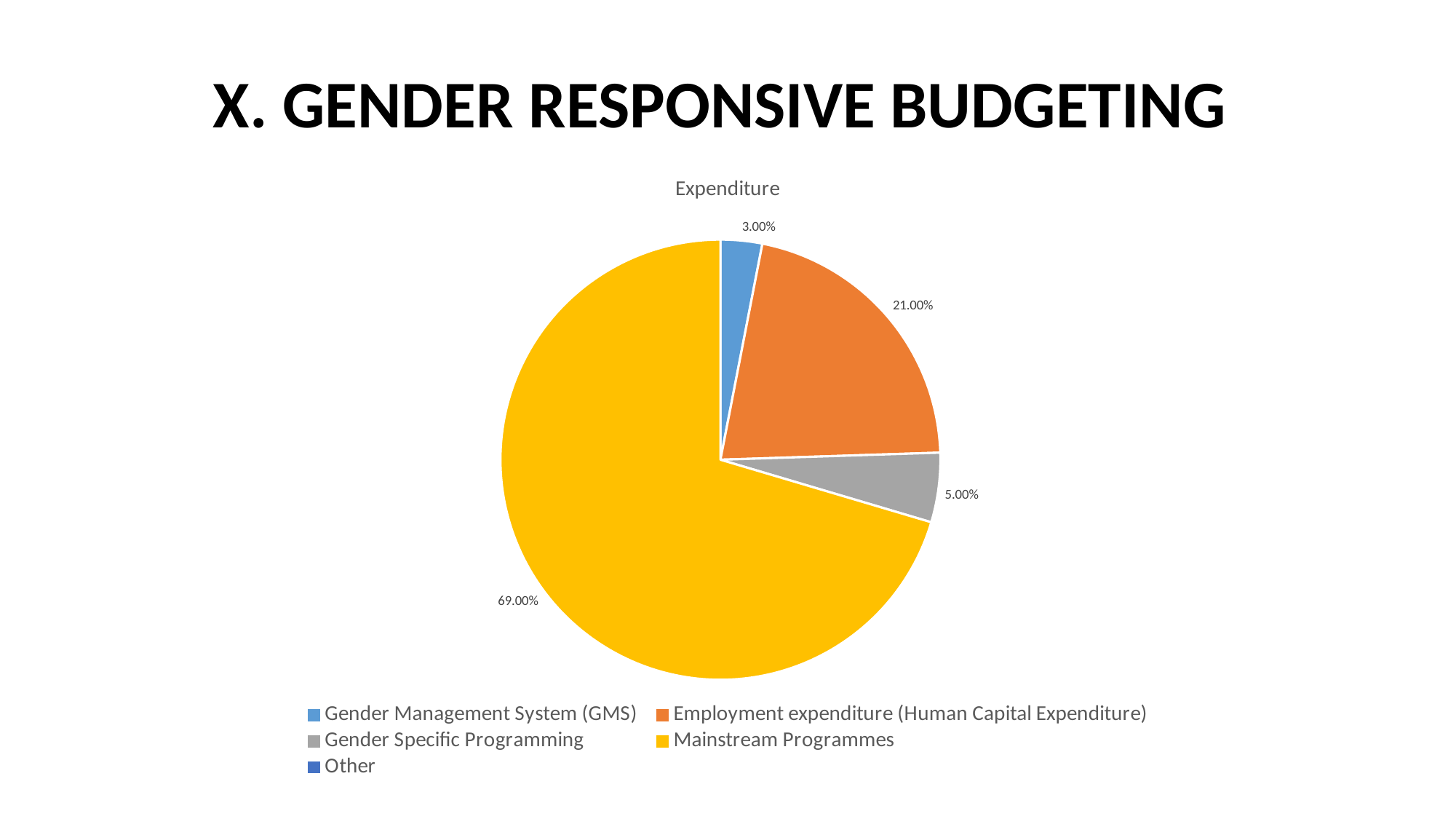
How many categories does the legend list? 5 What percentage of expenditure goes to Mainstream Programmes? 69.00% What colour is the Mainstream Programmes slice? yellow What type of chart is shown on the slide? pie chart What percentage of expenditure goes to the Gender Management System (GMS)? 3.00% What is the difference in percentage points between Mainstream Programmes and Employment expenditure (Human Capital Expenditure)? 48.00% Which is larger: the share for Gender Specific Programming or the share for Gender Management System (GMS)? Gender Specific Programming Which category has the largest share of expenditure? Mainstream Programmes What percentage of expenditure goes to Gender Specific Programming? 5.00% Which labelled slice has the smallest share of expenditure? Gender Management System (GMS) What percentage of expenditure is Employment expenditure (Human Capital Expenditure)? 21.00% What is the title of the chart? Expenditure